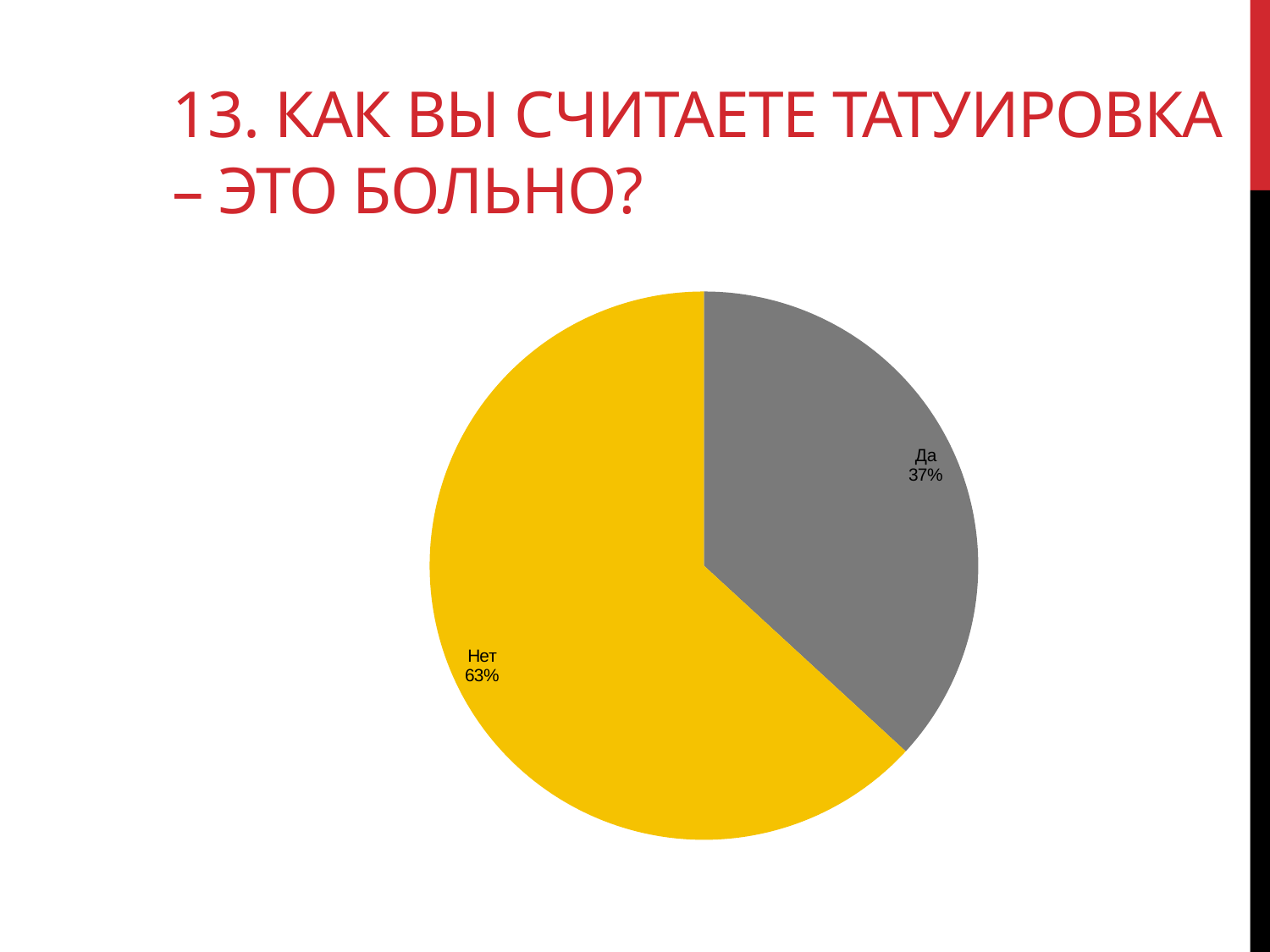
What is the difference in percentage points between the "Нет" and "Да" slices? 26 How many slices does the pie chart have? 2 Which slice of the pie is the largest? Нет What share of the pie does the "Да" slice represent? 37% What colour is the "Нет" slice? yellow Which slice of the pie is the smallest? Да What kind of chart is shown on the slide? pie chart Which is larger, the "Да" slice or the "Нет" slice? Нет What colour is the "Да" slice? grey What share of the pie does the "Нет" slice represent? 63%